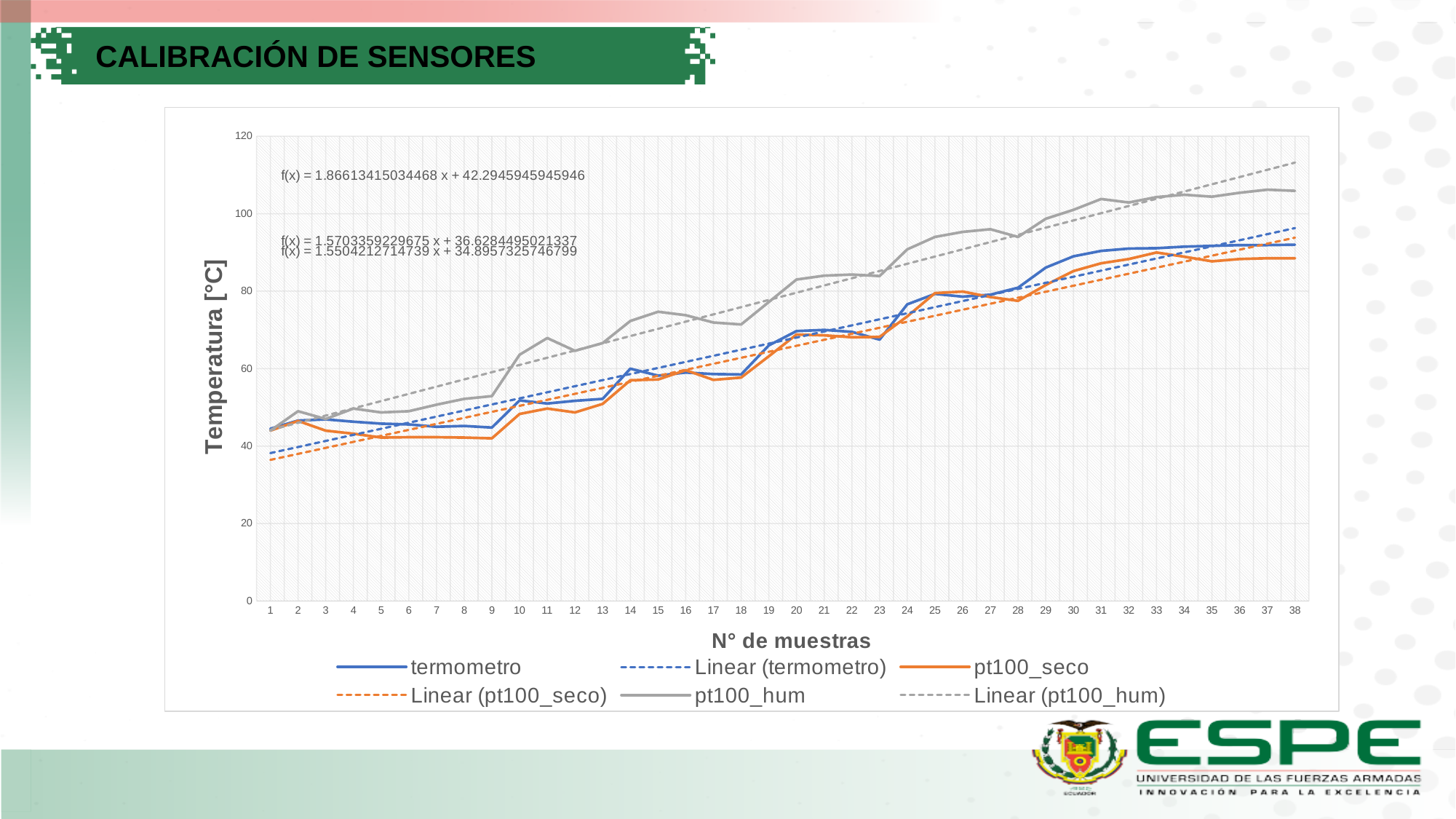
Is the value of termometro at sample 38 greater or less than 100? less At sample 30, which is larger: pt100_hum or pt100_seco? pt100_hum What is the title of the y axis? Temperatura [°C] How many entries does the chart legend list? 6 Which series reaches the highest temperature values on the chart? pt100_hum Is the value of pt100_seco at sample 20 greater or less than 60? greater What kind of chart is shown on the slide? line chart Is the value of termometro at sample 1 greater or less than 60? less Do the temperature values generally rise or fall as the sample number increases? rise What is the title of the x axis? N° de muestras How many sample points are shown along the x axis? 38